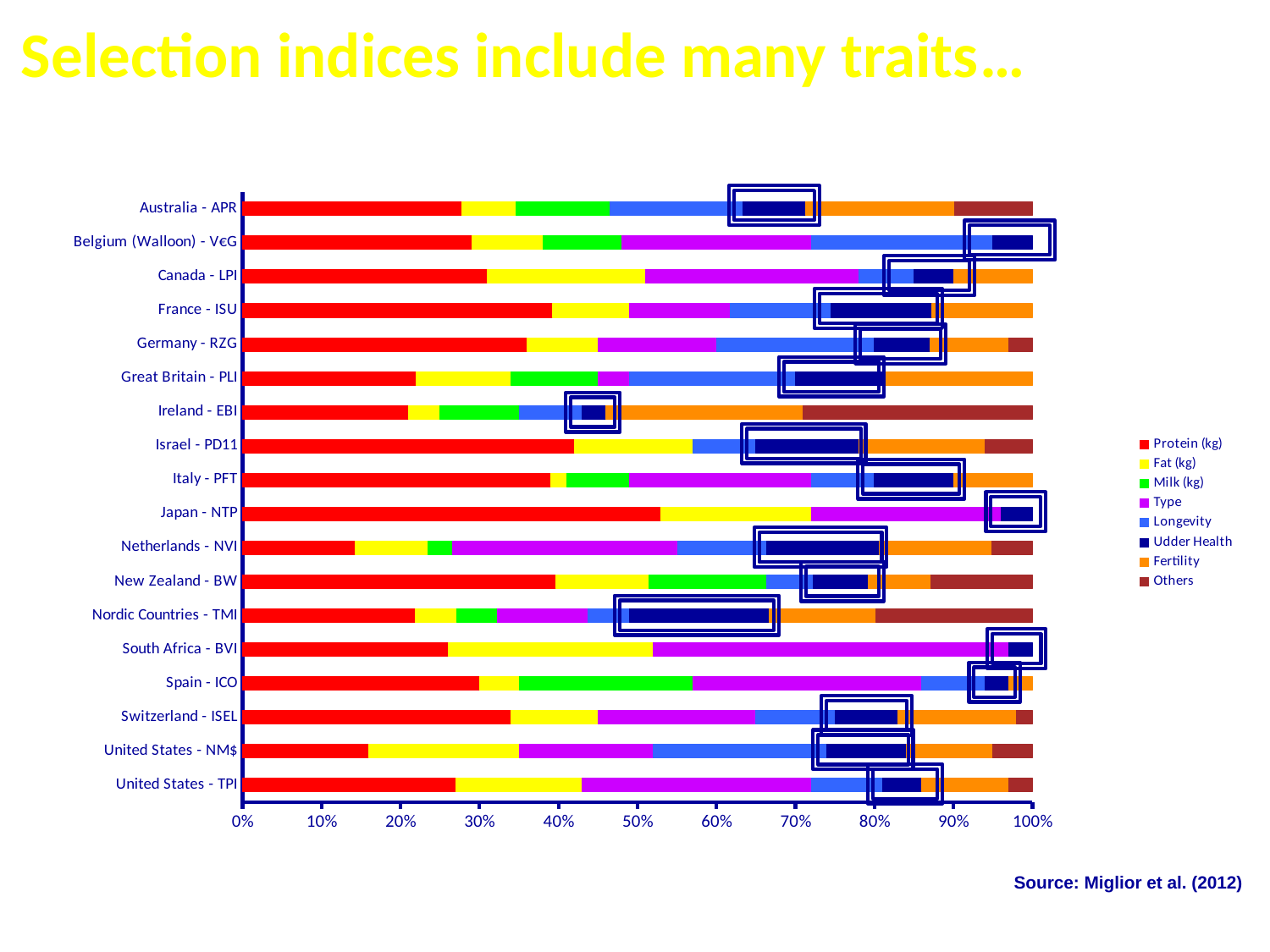
How many country/index categories are plotted on the chart? 18 How many series does the legend list? 8 Is the Protein (kg) value for Japan - NTP greater or less than 50%? greater Which category has the largest Milk (kg) segment? Spain - ICO What kind of chart is shown on the slide? stacked bar chart Is the Protein (kg) value for Netherlands - NVI greater or less than 20%? less Which category has the largest Type segment? South Africa - BVI What is the title of the slide containing the chart? Selection indices include many traits... Which category has the largest Others segment? Ireland - EBI Which has the larger Protein (kg) segment, Japan - NTP or Netherlands - NVI? Japan - NTP Which series is shown in red in the legend? Protein (kg)